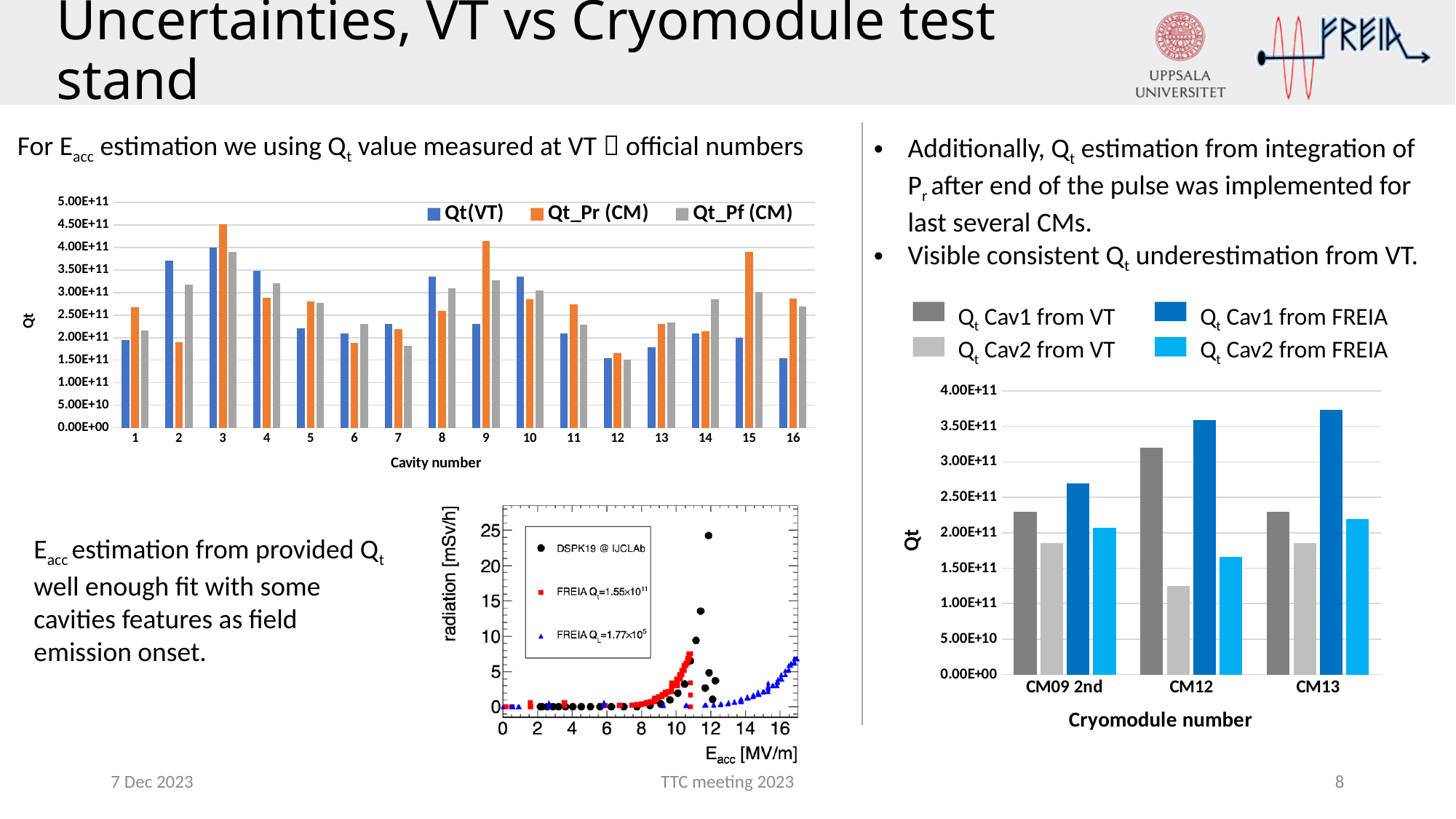
In the bottom-middle chart of radiation versus Eacc, how many series does the legend list? 3 What kind of chart is the right-hand chart of Qt versus cryomodule number? bar chart In the top-left chart of Qt versus cavity number, which is larger for cavity 15: Qt_Pr (CM) or Qt(VT)? Qt_Pr (CM) In the right-hand chart of Qt versus cryomodule number, how many series does the legend list? 4 In the top-left chart of Qt versus cavity number, which cavity has the highest Qt_Pr (CM) value? 3 In the top-left chart of Qt versus cavity number, is the Qt_Pr (CM) value for cavity 3 greater or less than 4.00E+11? greater In the top-left chart of Qt versus cavity number, which cavity has the highest Qt(VT) value? 3 In the top-left chart of Qt versus cavity number, how many cavities are plotted along the x axis? 16 In the top-left chart of Qt versus cavity number, how many series does the legend list? 3 In the right-hand chart of Qt versus cryomodule number, is the Qt Cav1 from VT value for CM12 greater or less than 3.00E+11? greater In the right-hand chart of Qt versus cryomodule number, which cryomodule has the lowest Qt Cav2 from VT value? CM12 In the top-left chart of Qt versus cavity number, is the Qt(VT) value for cavity 12 greater or less than 2.00E+11? less